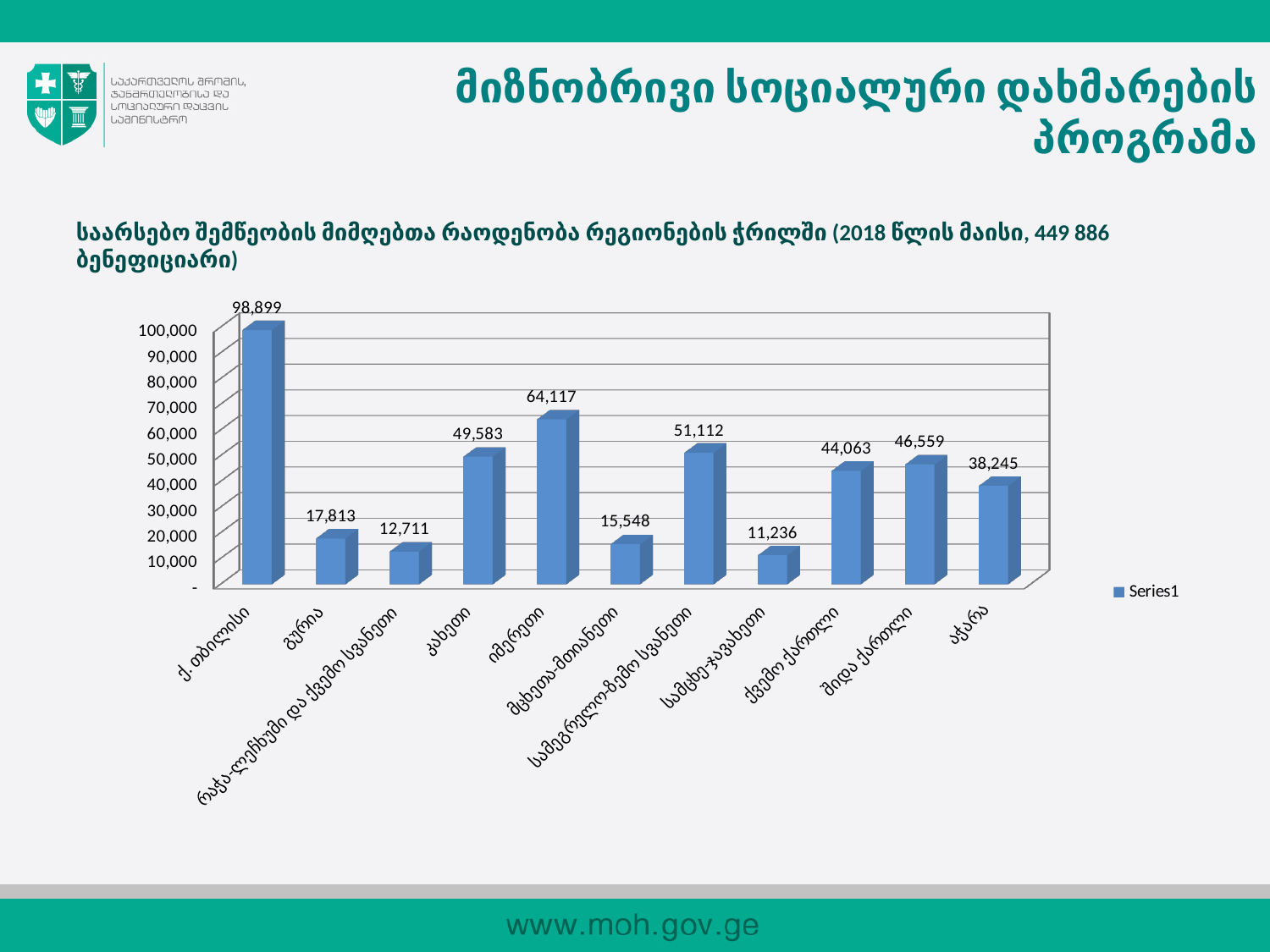
What is the value for აჭარა? 38,245 How many series does the legend list? 1 Is the value for სამეგრელო-ზემო სვანეთი greater or less than 40,000? greater What is the difference between the values for იმერეთი and კახეთი? 14,534 What is the value for სამცხე-ჯავახეთი? 11,236 Which category has the lowest value? სამცხე-ჯავახეთი Which is larger, the value for შიდა ქართლი or the value for ქვემო ქართლი? შიდა ქართლი What is the value for ქ. თბილისი? 98,899 Which category has the highest value? ქ. თბილისი What is the value for იმერეთი? 64,117 What kind of chart is shown on the slide? bar chart How many categories are shown on the x axis? 11